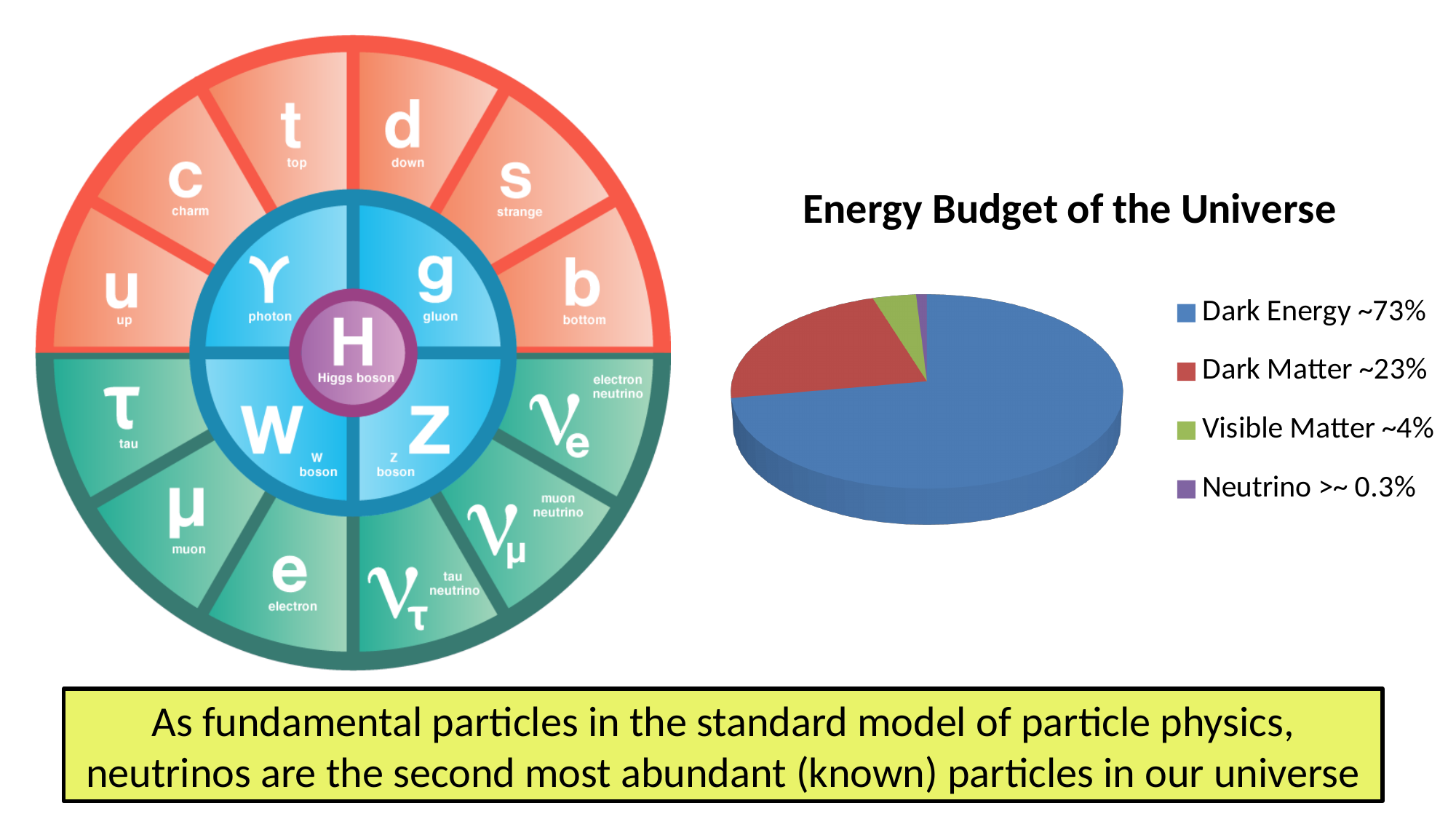
In the "Energy Budget of the Universe" pie chart, which category has the largest slice? Dark Energy What kind of chart is the "Energy Budget of the Universe" chart? pie chart In the "Energy Budget of the Universe" pie chart, which is larger: Visible Matter or Neutrino? Visible Matter What is the title of the pie chart on the right of the slide? Energy Budget of the Universe In the "Energy Budget of the Universe" pie chart, which is larger: Dark Energy or Dark Matter? Dark Energy In the "Energy Budget of the Universe" pie chart, which is larger: Dark Matter or Visible Matter? Dark Matter How many slices does the "Energy Budget of the Universe" pie chart have? 4 In the "Energy Budget of the Universe" pie chart, what colour is the Dark Energy slice? blue In the "Energy Budget of the Universe" pie chart, which category has the smallest slice? Neutrino